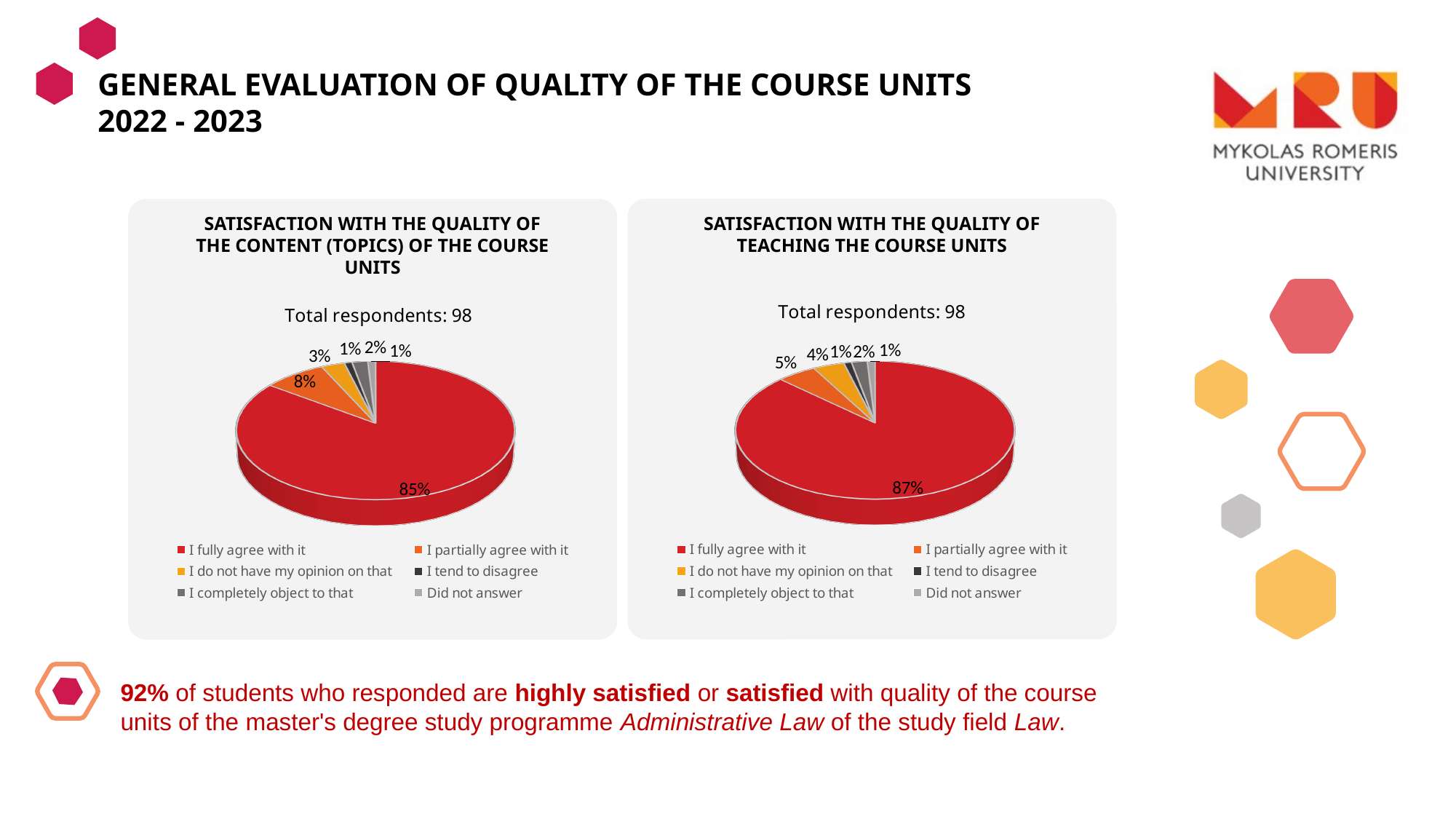
In the right chart (satisfaction with the quality of teaching the course units), what percentage of respondents chose 'I fully agree with it'? 87% In the left chart (satisfaction with the quality of the content of the course units), what percentage of respondents chose 'I fully agree with it'? 85% In the right chart (satisfaction with the quality of teaching the course units), what percentage chose 'I partially agree with it'? 5% In the left chart (satisfaction with the quality of the content of the course units), which response category has the largest share? I fully agree with it Which chart has the larger 'I partially agree with it' share: the left chart (content) or the right chart (teaching)? The left chart (content) What is the difference between the 'I fully agree with it' share in the right chart (teaching) and in the left chart (content)? 2% What is the title of the right chart? Satisfaction with the quality of teaching the course units How many response categories does the legend of the left chart list? 6 How many total respondents are reported for the right chart (satisfaction with the quality of teaching the course units)? 98 In the left chart (satisfaction with the quality of the content of the course units), what percentage chose 'I partially agree with it'? 8% In the right chart (satisfaction with the quality of teaching the course units), what percentage chose 'I do not have my opinion on that'? 4% What type of chart is used on this slide? Pie chart